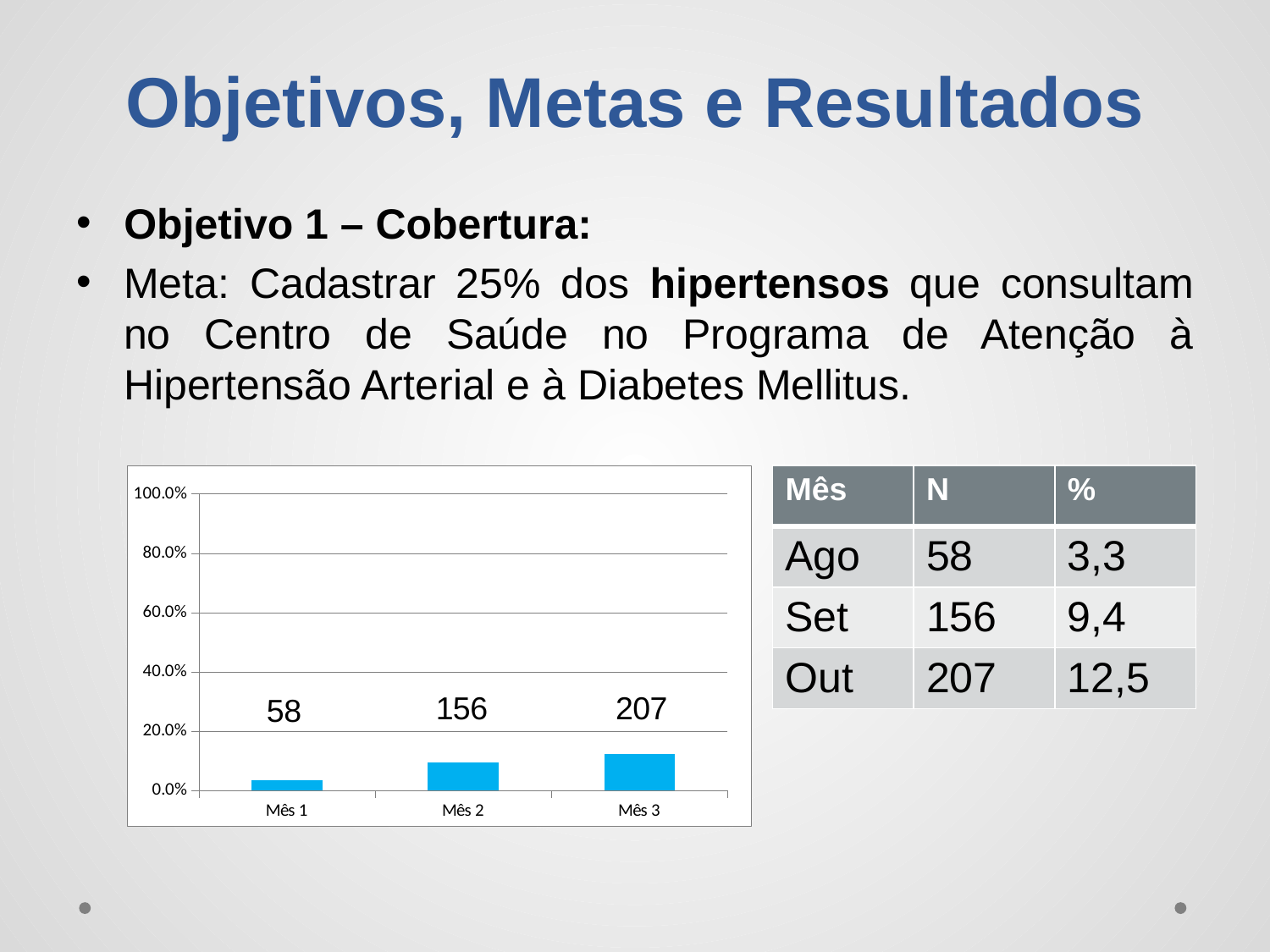
Which month has the shortest bar in the chart? Mês 1 What is the difference between the data labels for Mês 3 and Mês 1? 149 How many bars (categories) does the chart show? 3 Which month has the tallest bar in the chart? Mês 3 What is the data label shown on the bar for Mês 2? 156 Do the bar heights rise or fall from Mês 1 to Mês 3? rise Is the bar for Mês 3 greater or less than 20.0% on the y axis? less What is the data label shown on the bar for Mês 1? 58 What is the data label shown on the bar for Mês 3? 207 What type of chart is shown on the slide? bar chart Which bar is taller, Mês 2 or Mês 3? Mês 3 What is the difference between the data labels for Mês 2 and Mês 1? 98